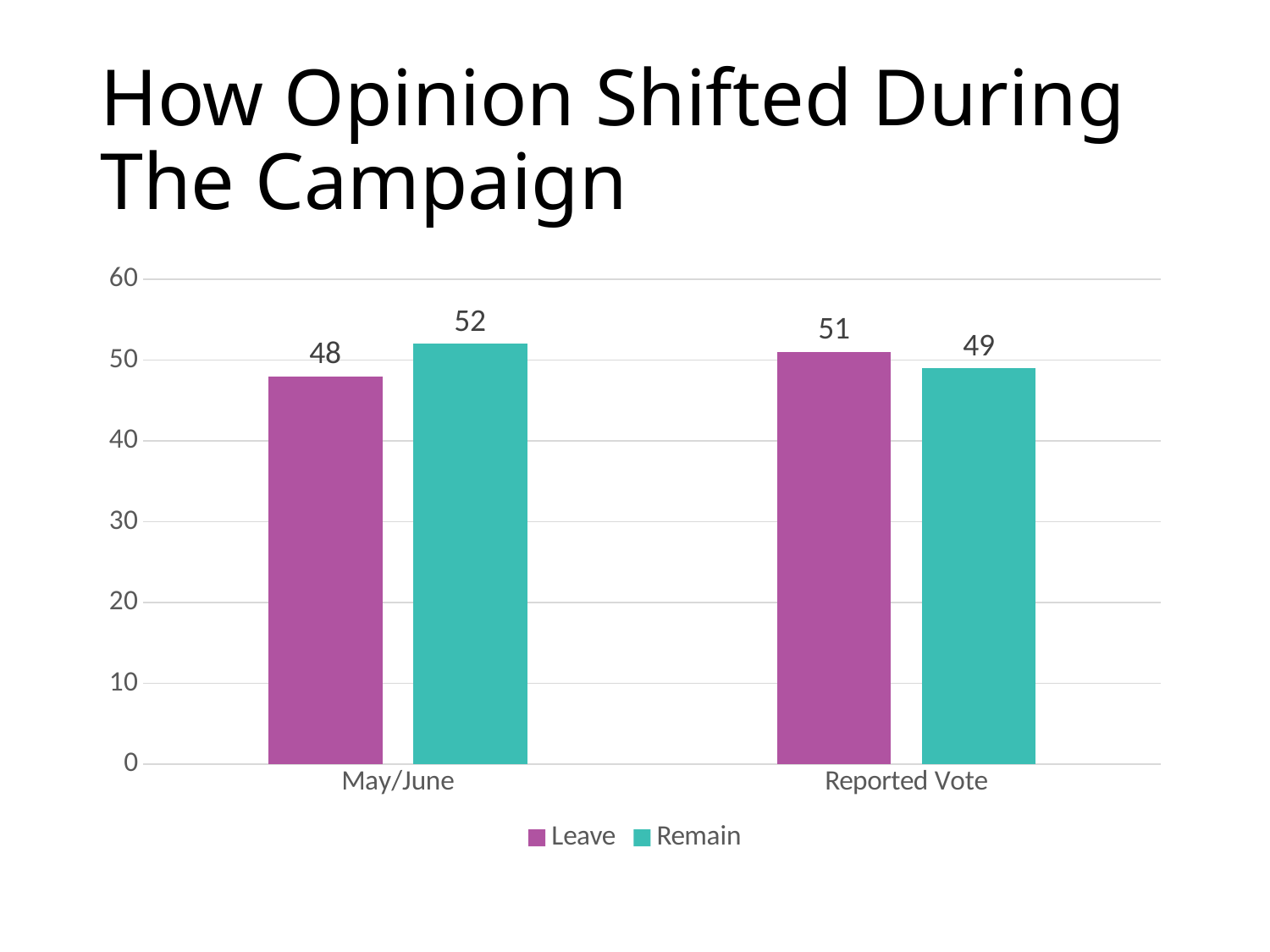
What is the value for Remain in May/June? 52 What is the value for Leave in May/June? 48 What is the value for Remain in the Reported Vote? 49 What is the difference between Remain and Leave in May/June? 4 Which series has the highest value in May/June? Remain Which series has the lowest value in the Reported Vote? Remain Does the value for Leave rise or fall from May/June to Reported Vote? rise How many categories are shown on the x axis? 2 Is the value for Leave in May/June greater or less than 50? less What kind of chart is shown on the slide? bar chart How many series does the legend list? 2 What is the value for Leave in the Reported Vote? 51